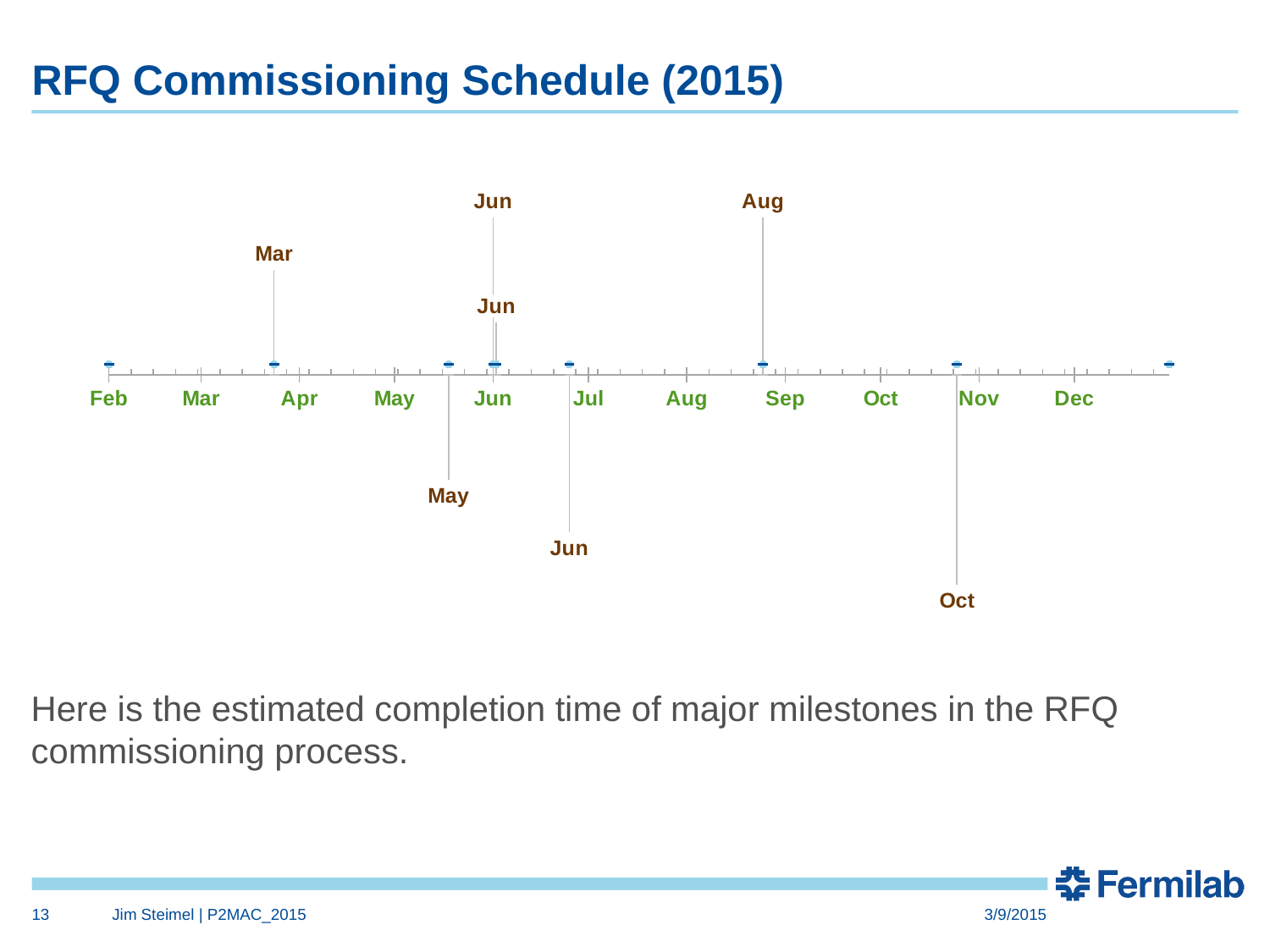
What is the earliest labelled milestone on the timeline? Mar What kind of chart is shown on the slide? A timeline chart What is the title of the chart on the slide? RFQ Commissioning Schedule (2015) Which labelled milestone falls between the Mar milestone and the Jun milestones? May What is the first month shown on the timeline axis? Feb Does the Aug milestone come before or after the Oct milestone on the timeline? Before What is the latest labelled milestone on the timeline? Oct How many month labels are shown along the timeline axis? 11 Which labelled milestone comes immediately after the Aug milestone? Oct How many milestones on the timeline are labelled "Jun"? 3 Which month has the most milestones on the timeline? Jun How many milestone labels are shown on the timeline? 7